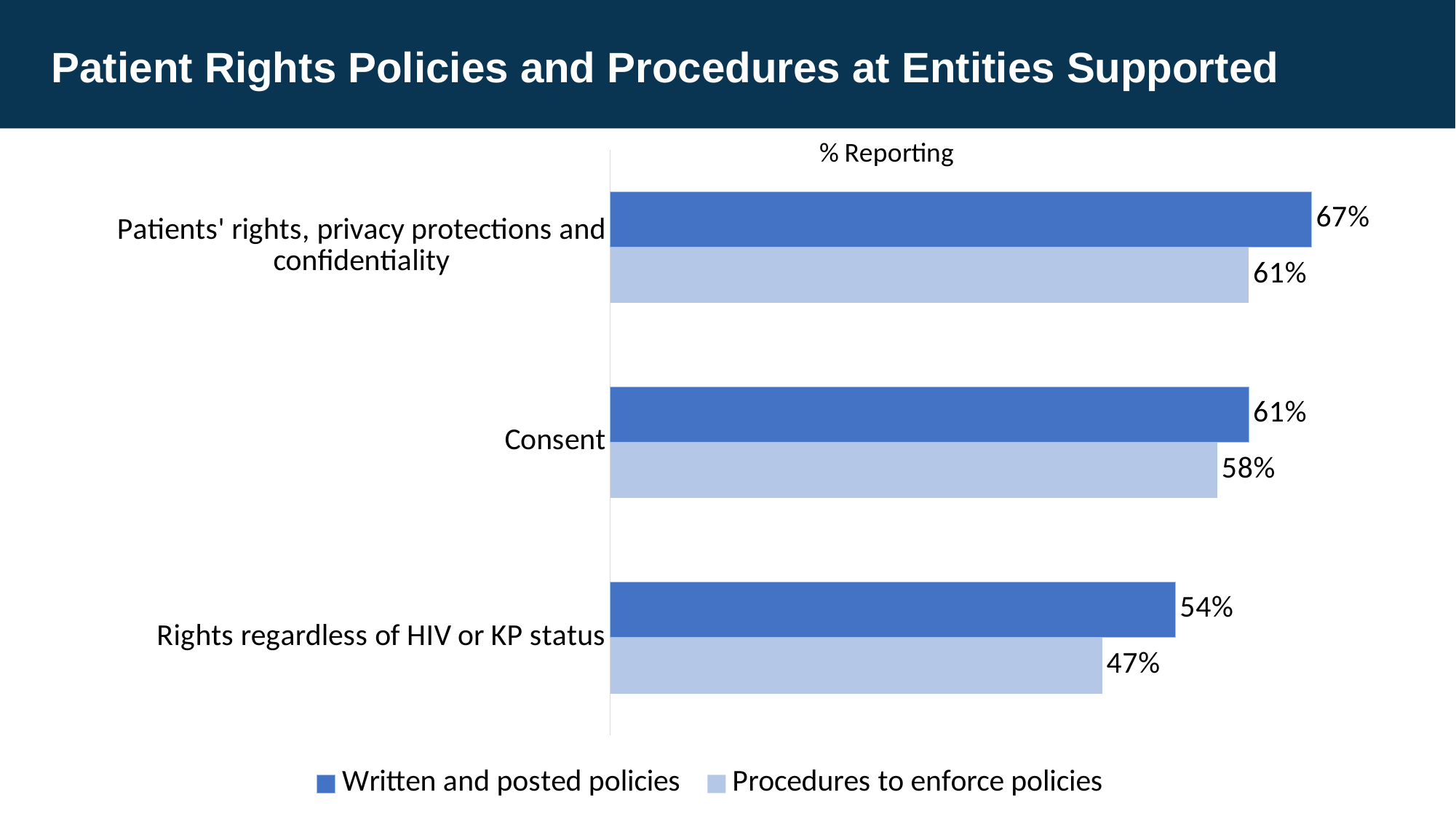
What kind of chart is shown on the slide? Bar chart What is the difference between written and posted policies and procedures to enforce policies for rights regardless of HIV or KP status? 7% What is the label shown above the chart's plot area? % Reporting How many series does the legend list? 2 What percentage of entities report procedures to enforce policies for consent? 58% Which category has the highest value for written and posted policies? Patients' rights, privacy protections and confidentiality What is the difference between the written and posted policies values for patients' rights, privacy protections and confidentiality and for consent? 6% How many categories are shown on the chart? 3 For consent, which is larger: written and posted policies or procedures to enforce policies? Written and posted policies Which category has the lowest value for procedures to enforce policies? Rights regardless of HIV or KP status What percentage of entities report procedures to enforce policies for rights regardless of HIV or KP status? 47% What percentage of entities report written and posted policies for patients' rights, privacy protections and confidentiality? 67%